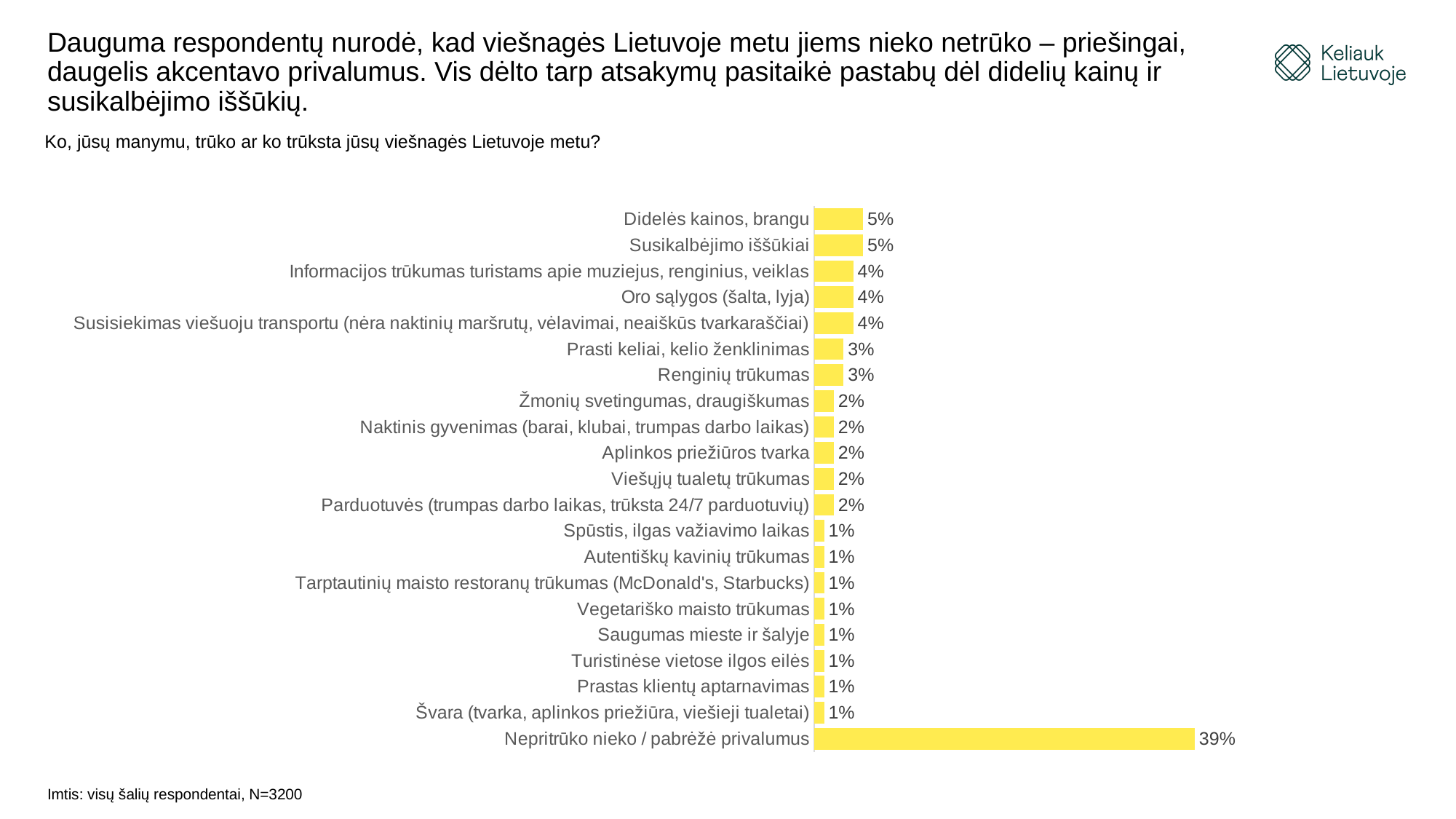
What is the value for "Oro sąlygos (šalta, lyja)"? 4% How many categories are shown in the chart? 21 What is the value for "Didelės kainos, brangu"? 5% Which is larger: "Informacijos trūkumas turistams apie muziejus, renginius, veiklas" or "Žmonių svetingumas, draugiškumas"? Informacijos trūkumas turistams apie muziejus, renginius, veiklas What is the value for "Viešųjų tualetų trūkumas"? 2% What colour are the bars in the chart? Yellow What is the difference between "Nepritrūko nieko / pabrėžė privalumus" and "Susikalbėjimo iššūkiai"? 34% What kind of chart is shown on the slide? Bar chart Which category has the highest value? Nepritrūko nieko / pabrėžė privalumus What is the difference between "Didelės kainos, brangu" and "Renginių trūkumas"? 2% What is the value for "Prasti keliai, kelio ženklinimas"? 3% What is the value for "Nepritrūko nieko / pabrėžė privalumus"? 39%